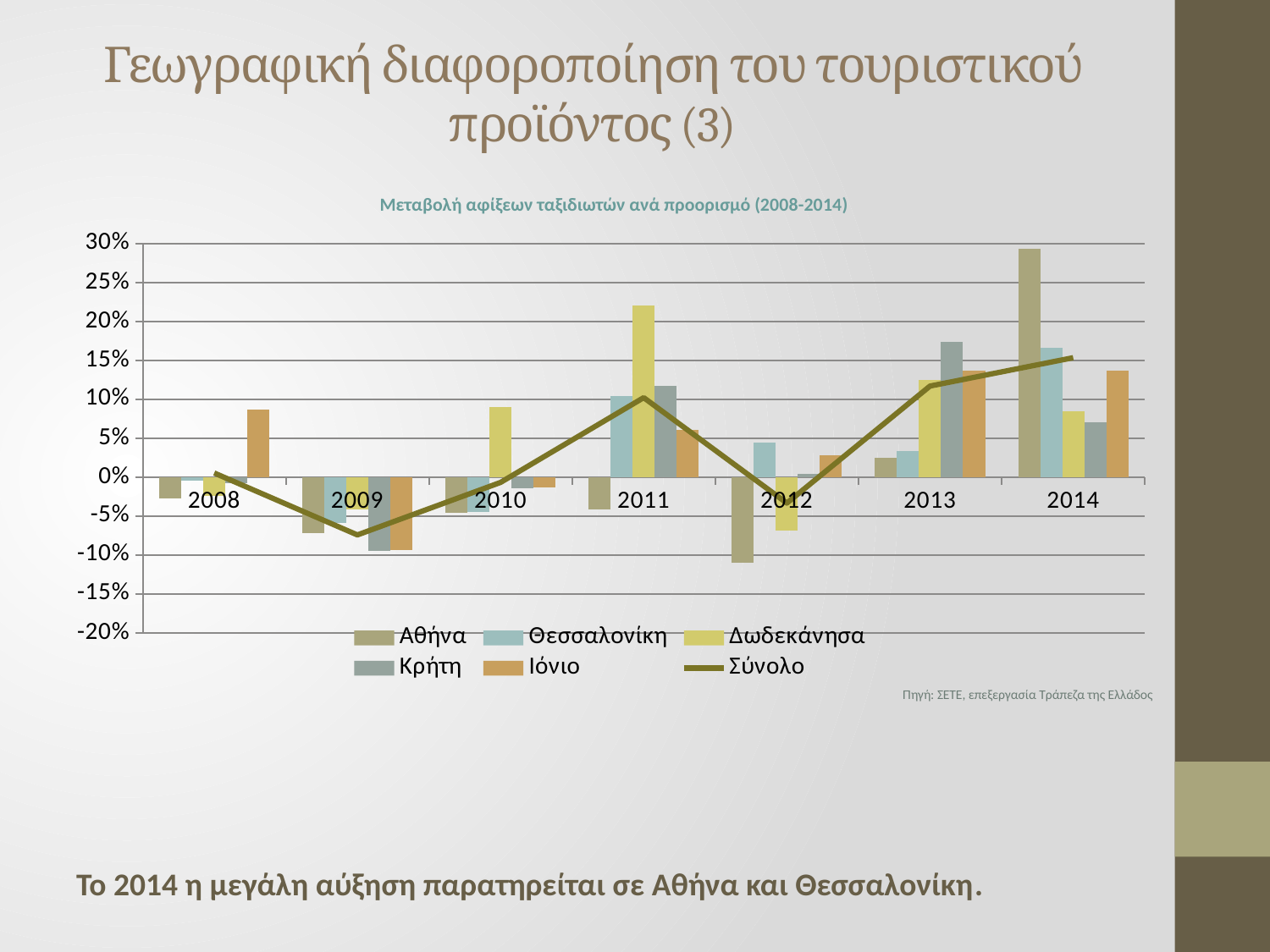
Is the value for Αθήνα in 2014 greater or less than 25%? greater In 2011, which is larger: the value for Δωδεκάνησα or the value for Κρήτη? Δωδεκάνησα How many years are shown on the x axis of the chart? 7 Is the value for Κρήτη in 2013 greater or less than 15%? greater What is the title of the chart? Μεταβολή αφίξεων ταξιδιωτών ανά προορισμό (2008-2014) Is the value for Αθήνα in 2012 greater or less than -10%? less In 2014, which is larger: the value for Αθήνα or the value for Θεσσαλονίκη? Αθήνα What kind of chart is shown on the slide? A combined bar and line chart How many series does the chart legend list? 6 In which year is the bar for Αθήνα the highest? 2014 In which year does the Σύνολο line reach its lowest point? 2009